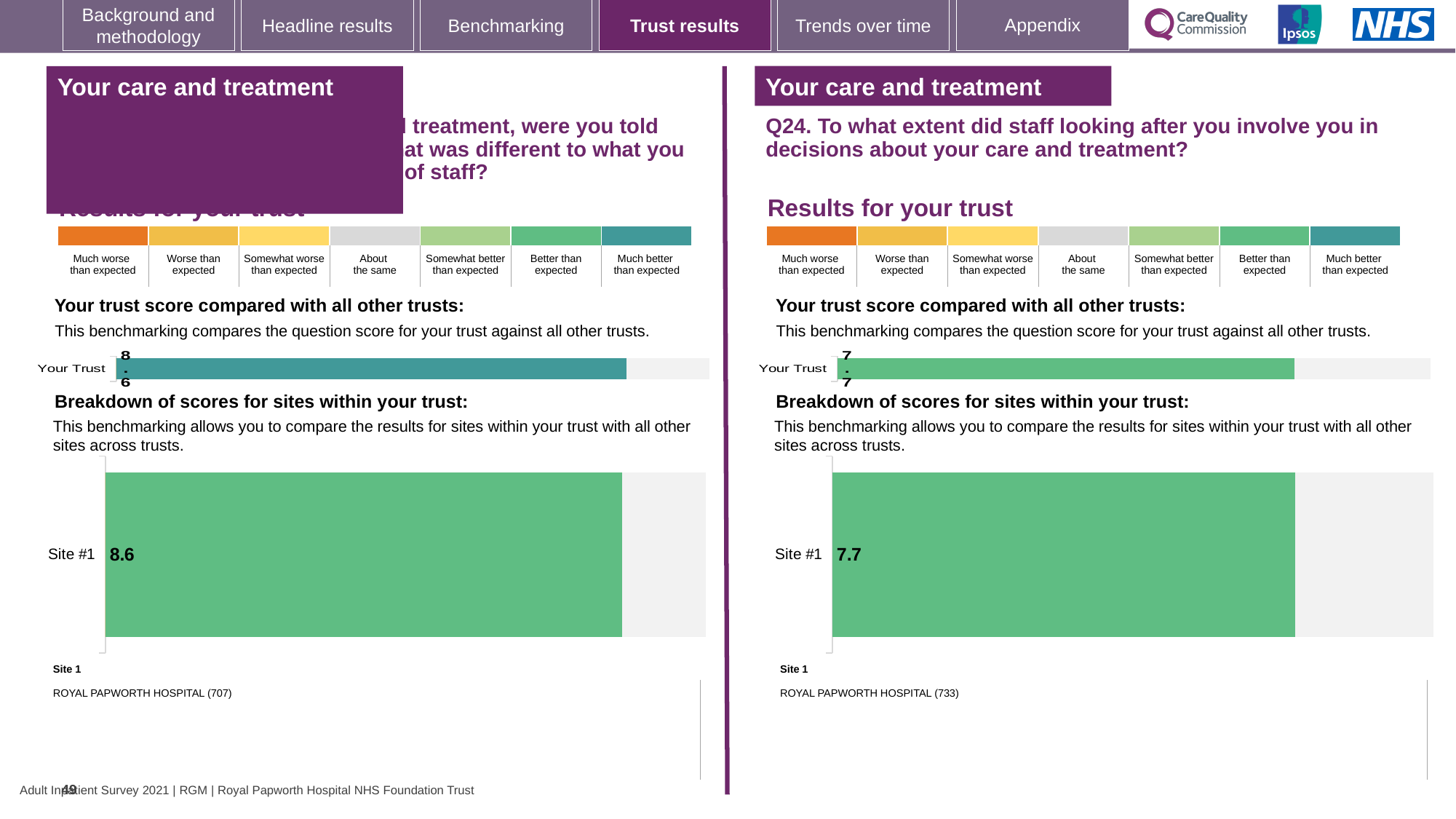
How many sites are shown on the left-hand 'Breakdown of scores for sites within your trust' chart? 1 On the right-hand Q24 site breakdown chart, which hospital is listed as Site 1? ROYAL PAPWORTH HOSPITAL (733) On the left-hand 'Your trust score compared with all other trusts' chart, what is the score for Your Trust? 8.6 What kind of chart is the right-hand Q24 'Breakdown of scores for sites within your trust' chart? Bar chart What kind of chart is the left-hand 'Your trust score compared with all other trusts' chart? Bar chart How many sites are shown on the right-hand Q24 'Breakdown of scores for sites within your trust' chart? 1 On the right-hand Q24 'Breakdown of scores for sites within your trust' chart, what is the score for Site #1? 7.7 On the left-hand site breakdown chart, which hospital is listed as Site 1? ROYAL PAPWORTH HOSPITAL (707) On the left-hand 'Breakdown of scores for sites within your trust' chart, what is the score for Site #1? 8.6 On the right-hand Q24 'Your trust score compared with all other trusts' chart, what is the score for Your Trust? 7.7 What is the difference between the Site #1 score on the left-hand site breakdown chart and the Site #1 score on the right-hand Q24 site breakdown chart? 0.9 Which is larger: the Site #1 score on the left-hand site breakdown chart or the Site #1 score on the right-hand Q24 site breakdown chart? Left-hand chart (8.6)